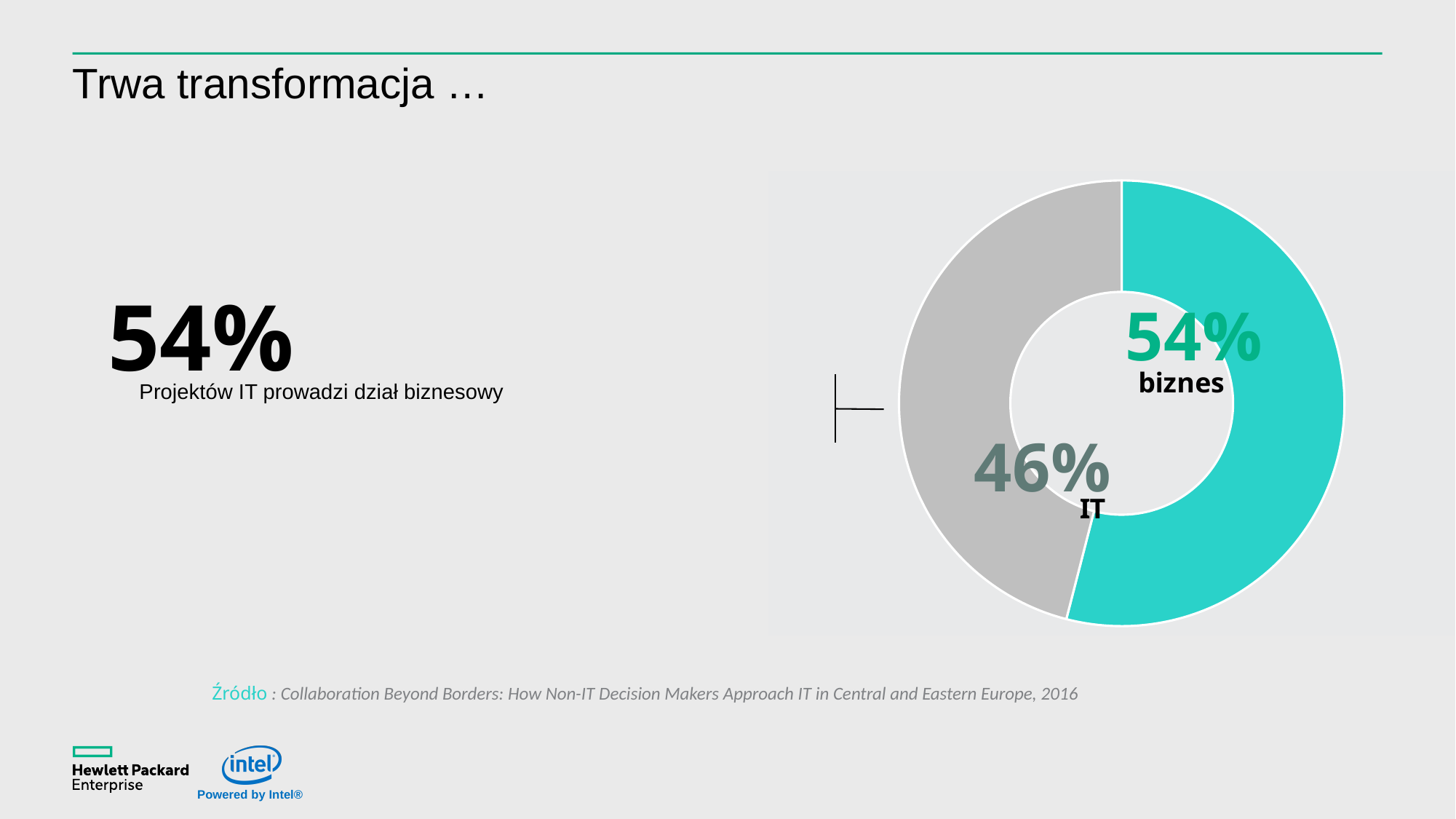
Which slice of the doughnut chart is the largest? biznes What colour is the "biznes" slice of the doughnut chart? Teal (turquoise) Which slice of the doughnut chart is the smallest? IT What kind of chart is shown on the slide? Doughnut (pie) chart What share of the doughnut chart is labelled "biznes"? 54% What colour is the "IT" slice of the doughnut chart? Grey What is the total of the two slices in the doughnut chart? 100% What share of the doughnut chart is labelled "IT"? 46% How many slices does the doughnut chart have? 2 What is the difference in percentage points between the "biznes" slice and the "IT" slice? 8 percentage points Is the share for "IT" greater or less than 50%? less Which slice is larger, "biznes" or "IT"? biznes